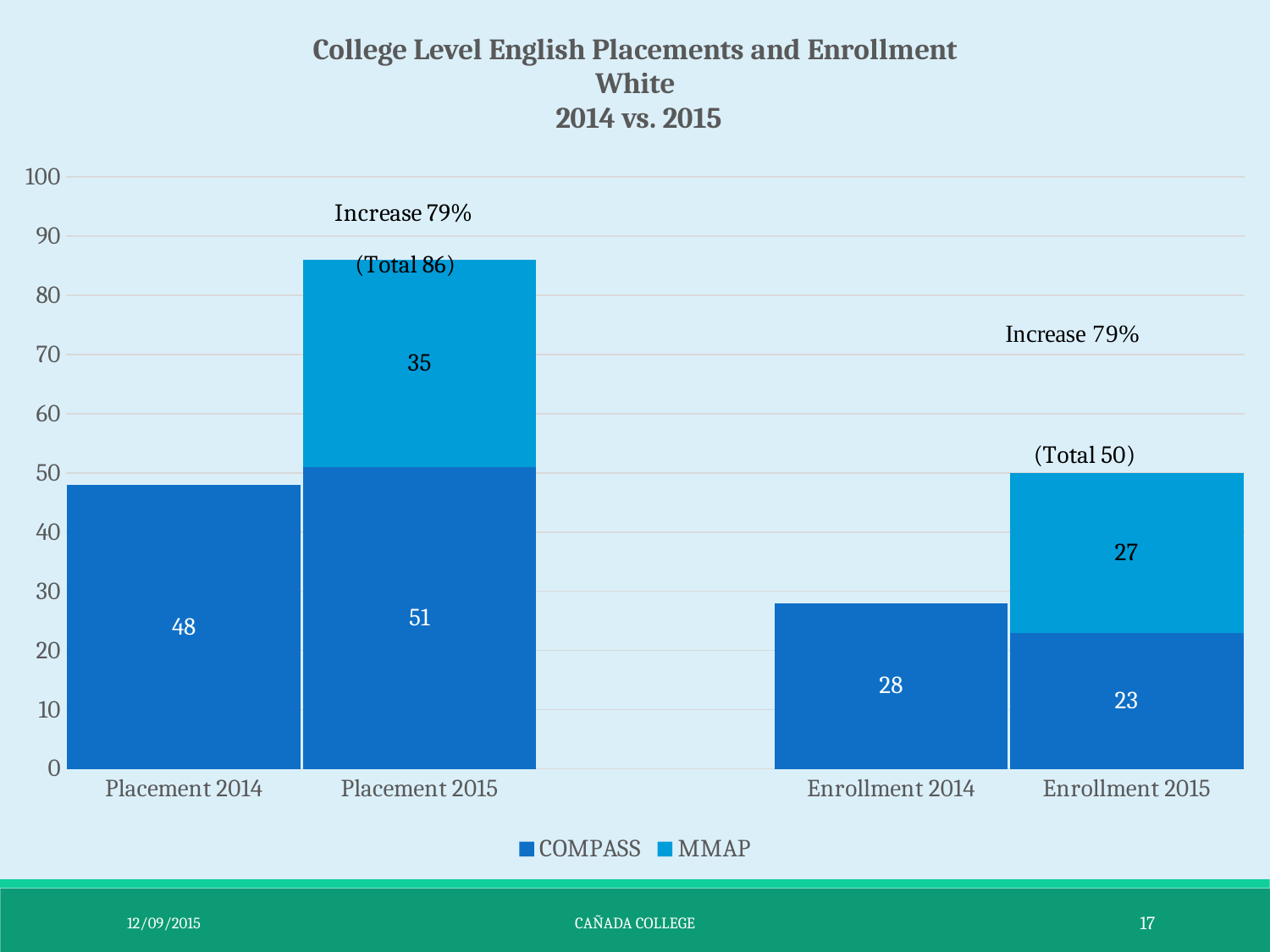
How many categories are shown on the x axis? 4 Which is larger, the COMPASS value for Enrollment 2014 or the COMPASS value for Enrollment 2015? Enrollment 2014 What percentage increase is annotated above the Placement 2015 bar? 79% What is the total of the stacked bar for Enrollment 2015? 50 What is the MMAP value for Placement 2015? 35 How many series does the legend list? 2 What is the difference between the COMPASS values for Placement 2015 and Placement 2014? 3 What is the COMPASS value for Placement 2014? 48 What is the COMPASS value for Enrollment 2015? 23 What is the total of the stacked bar for Placement 2015? 86 What kind of chart is shown on the slide? Stacked bar chart Which category has the lowest COMPASS value? Enrollment 2015